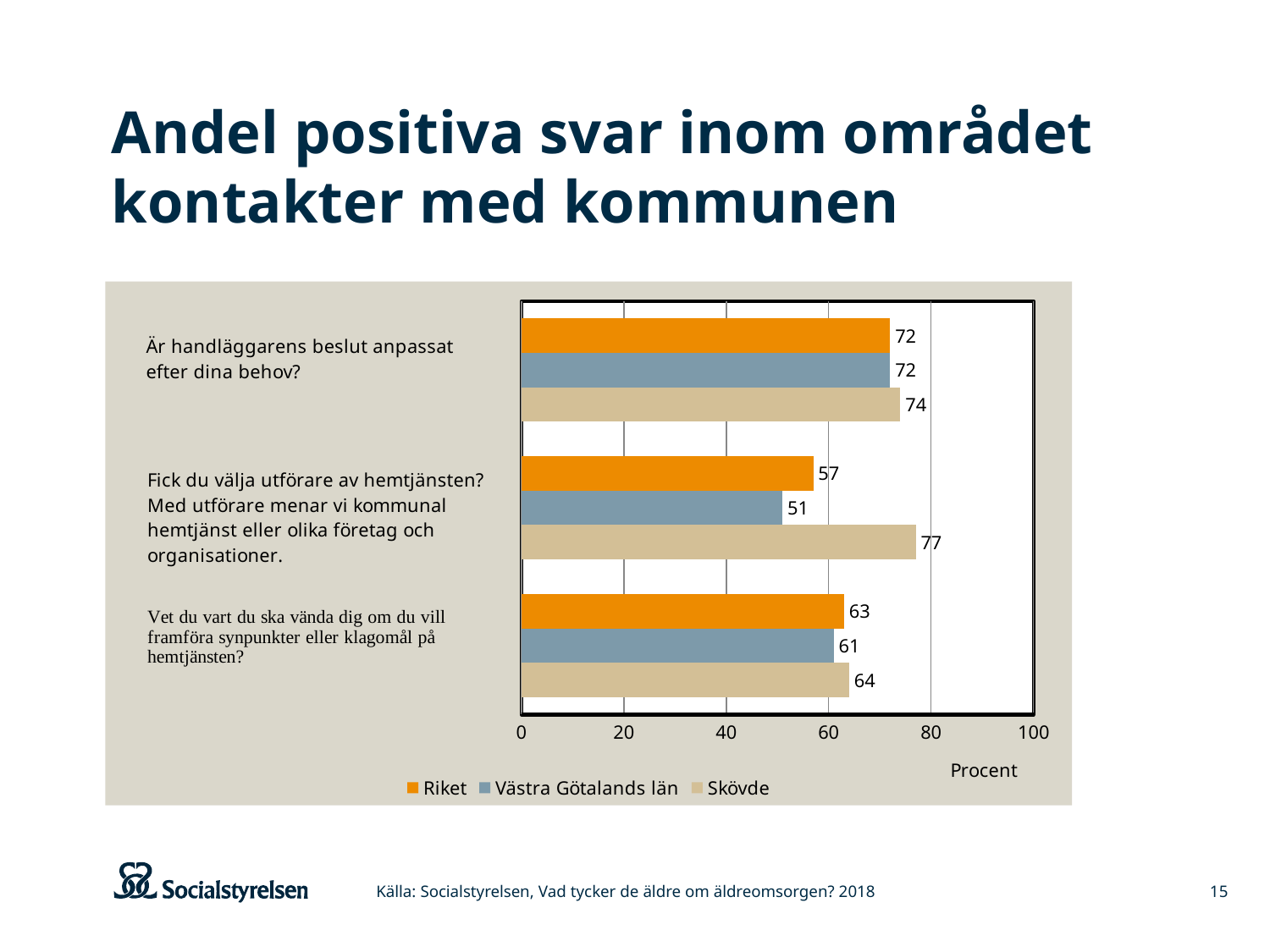
What is the value for Riket on the question "Är handläggarens beslut anpassat efter dina behov?"? 72 Is the value for Skövde on the question "Är handläggarens beslut anpassat efter dina behov?" greater or less than 60? greater Which series has the lowest value on the question "Fick du välja utförare av hemtjänsten?"? Västra Götalands län Which is larger: the Riket value or the Västra Götalands län value on the question "Vet du vart du ska vända dig om du vill framföra synpunkter eller klagomål på hemtjänsten?"? Riket How many questions (categories) are shown in the chart? 3 What is the difference between the Skövde and Västra Götalands län values on the question "Fick du välja utförare av hemtjänsten?"? 26 How many series does the legend list? 3 What kind of chart is shown on the slide? Bar chart What unit is shown on the horizontal axis of the chart? Procent What is the value for Västra Götalands län on the question "Vet du vart du ska vända dig om du vill framföra synpunkter eller klagomål på hemtjänsten?"? 61 What is the value for Skövde on the question "Fick du välja utförare av hemtjänsten?"? 77 Which series has the highest value on the question "Fick du välja utförare av hemtjänsten?"? Skövde